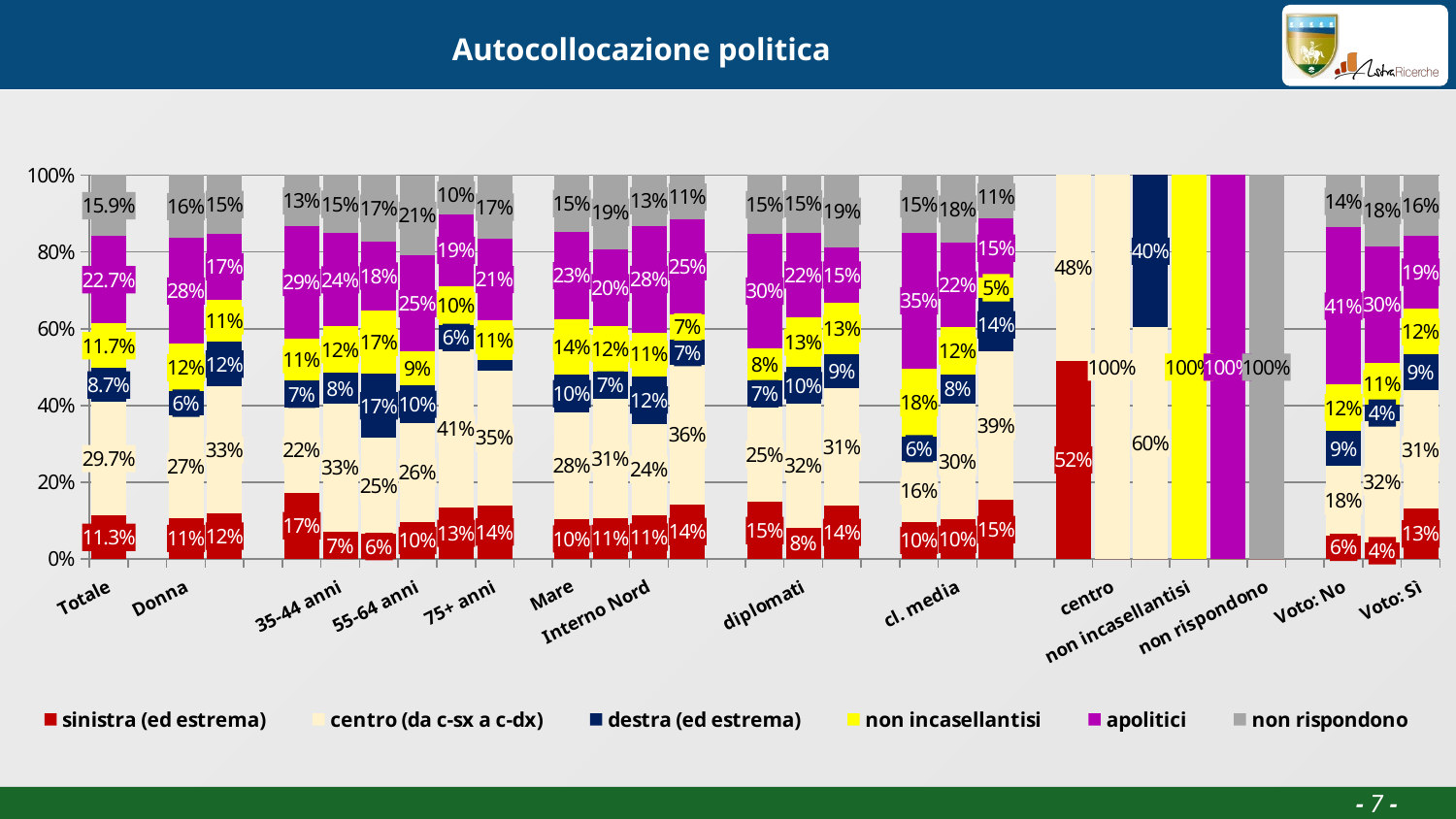
What is the value of 'destra (ed estrema)' for Donna? 6% Which segment is the largest in the Totale bar? centro (da c-sx a c-dx) What kind of chart is shown on the slide? stacked bar chart What is the value of 'centro (da c-sx a c-dx)' for Totale? 29.7% What is the difference between 'apolitici' and 'non incasellantisi' for Totale? 11 percentage points What is the value of 'non rispondono' for Totale? 15.9% What is the value of 'apolitici' for Totale? 22.7% How many series does the legend list? 6 What is the value of 'apolitici' for Donna? 28% What is the title of the chart? Autocollocazione politica What is the value of 'centro (da c-sx a c-dx)' for the category 'centro'? 100% What is the value of 'sinistra (ed estrema)' for Totale? 11.3%